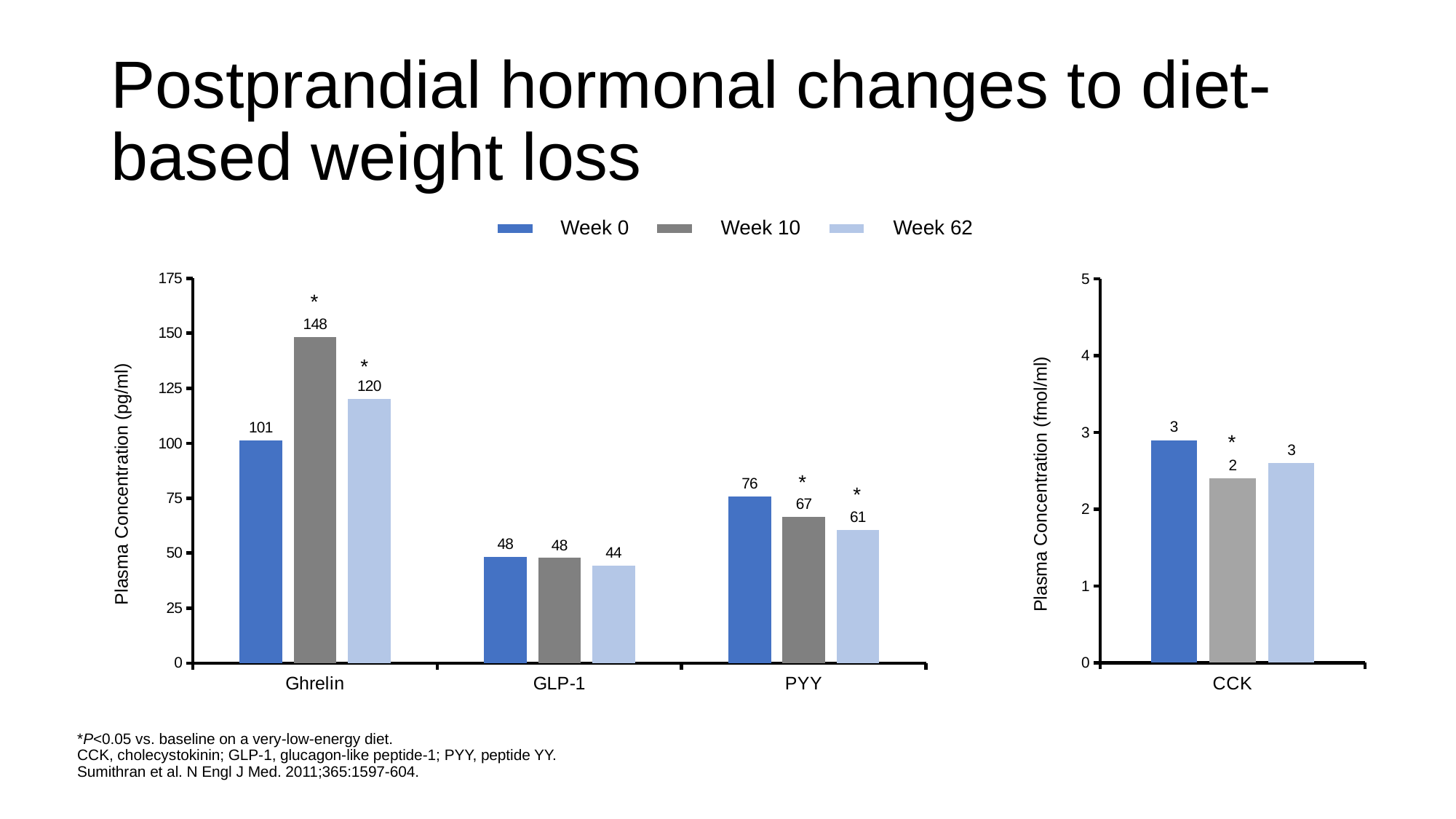
What is the y-axis label of the right chart? Plasma Concentration (fmol/ml) On the left chart, what is the Week 10 value for Ghrelin? 148 On the left chart, what is the Week 0 value for GLP-1? 48 How many series does the legend list? 3 On the right chart, is the Week 10 value for CCK greater or less than 3? less On the left chart, what is the difference between the Week 10 and Week 0 values for Ghrelin? 47 On the left chart, which hormone has the lowest Week 62 value? GLP-1 On the left chart, which hormone has the highest Week 0 value? Ghrelin On the left chart, which is larger for Ghrelin: the Week 62 value or the Week 0 value? Week 62 On the left chart, what is the difference between the Week 0 and Week 62 values for PYY? 15 On the left chart, what is the Week 62 value for PYY? 61 How many hormone categories are shown on the left chart? 3